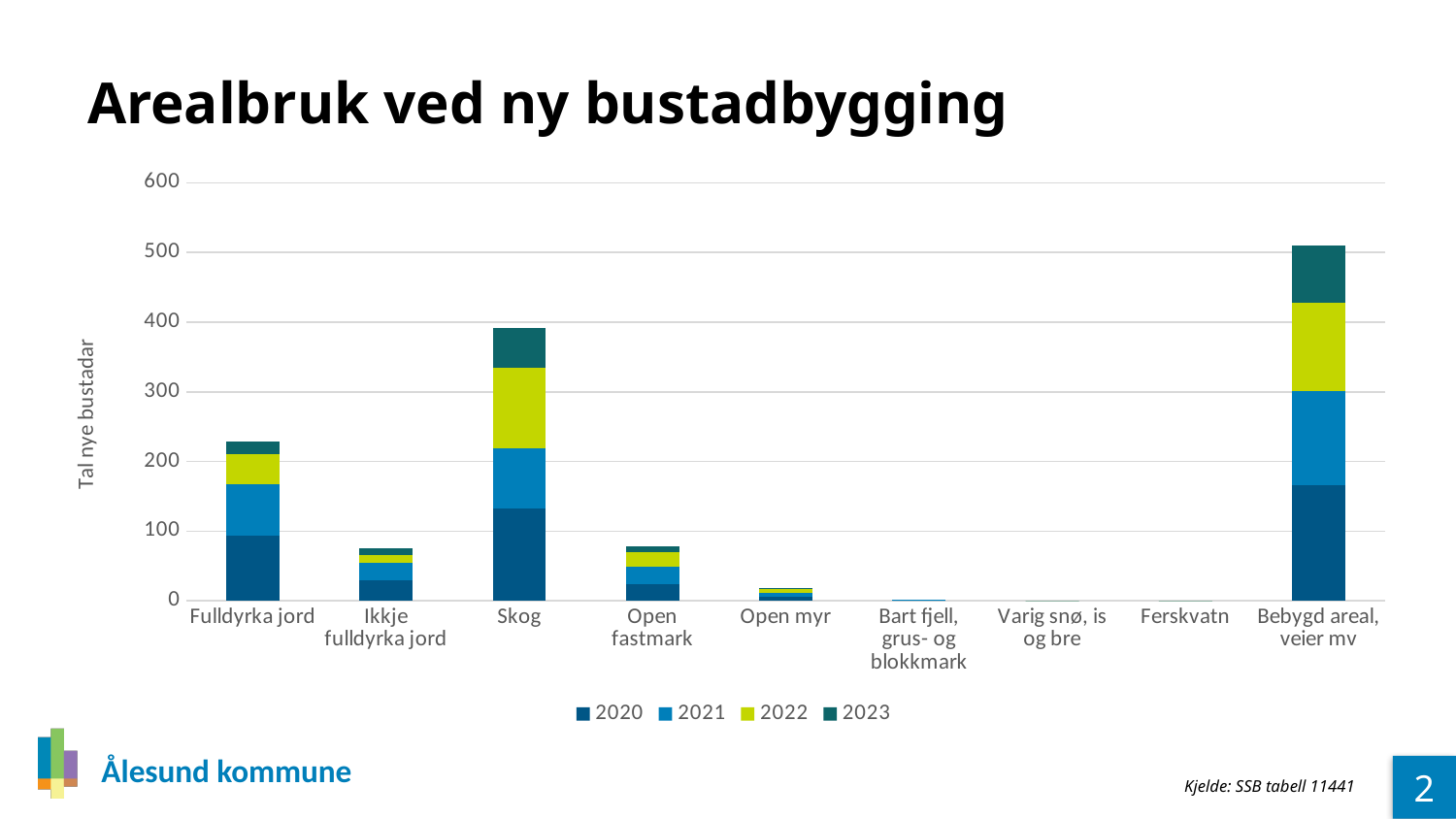
What is the title of the chart? Arealbruk ved ny bustadbygging Which has a larger total, Open fastmark or Open myr? Open fastmark How many series does the legend list? 4 Which category has the highest total stacked bar? Bebygd areal, veier mv How many categories are shown on the x axis? 9 Is the total value for Skog greater or less than 300? greater Is the total value for Fulldyrka jord greater or less than 200? greater Which has a larger total, Skog or Fulldyrka jord? Skog Is the total value for Ikkje fulldyrka jord greater or less than 100? less What type of chart is shown on the slide? Stacked bar chart What is the label of the y axis? Tal nye bustadar